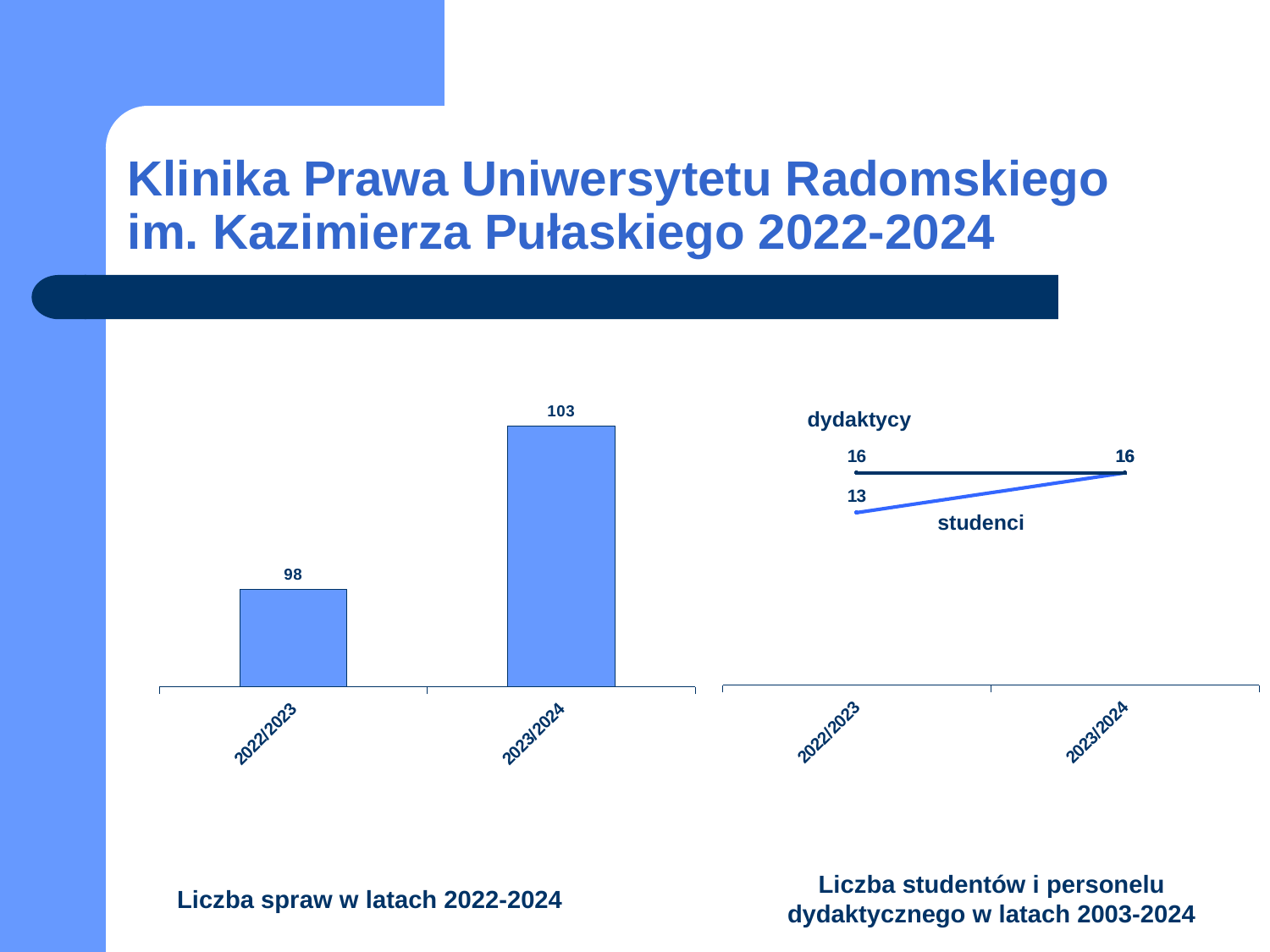
In the chart titled 'Liczba spraw w latach 2022-2024', what is the value for 2023/2024? 103 In the chart titled 'Liczba spraw w latach 2022-2024', do the values rise or fall from 2022/2023 to 2023/2024? rise What kind of chart is the one titled 'Liczba studentów i personelu dydaktycznego w latach 2003-2024'? line chart In the chart titled 'Liczba studentów i personelu dydaktycznego w latach 2003-2024', which series has the larger value in 2022/2023, dydaktycy or studenci? dydaktycy What kind of chart is the one titled 'Liczba spraw w latach 2022-2024'? bar chart In the chart titled 'Liczba studentów i personelu dydaktycznego w latach 2003-2024', what is the value for dydaktycy in 2022/2023? 16 In the chart titled 'Liczba spraw w latach 2022-2024', what is the difference between the values for 2023/2024 and 2022/2023? 5 In the chart titled 'Liczba studentów i personelu dydaktycznego w latach 2003-2024', what is the value for studenci in 2022/2023? 13 In the chart titled 'Liczba spraw w latach 2022-2024', what is the value for 2022/2023? 98 In the chart titled 'Liczba spraw w latach 2022-2024', which year has the highest value? 2023/2024 In the chart titled 'Liczba spraw w latach 2022-2024', how many bars are shown? 2 In the chart titled 'Liczba spraw w latach 2022-2024', which year has the lowest value? 2022/2023